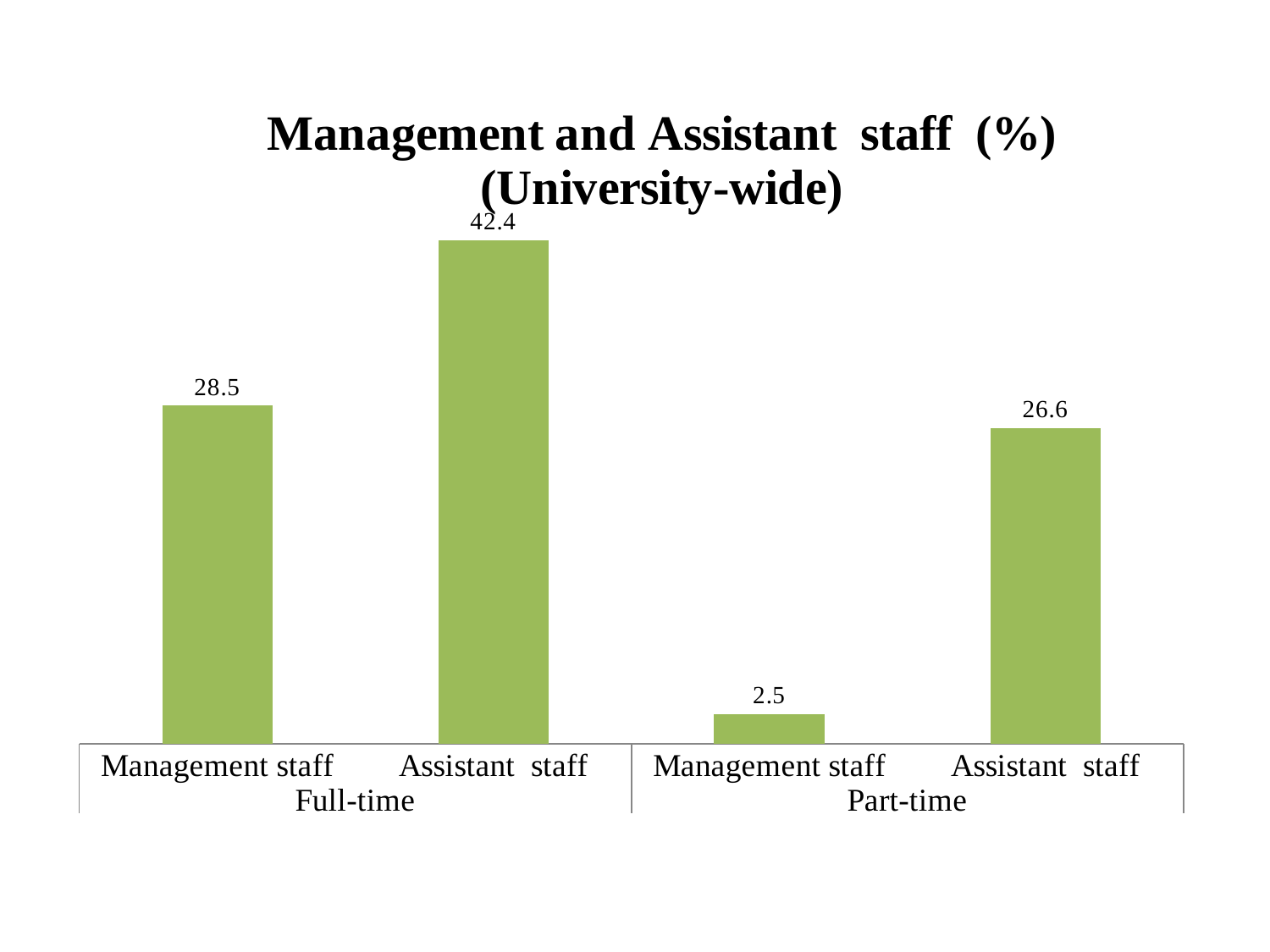
Which category has the highest value? Full-time Assistant staff Which category has the lowest value? Part-time Management staff What is the value for Part-time Assistant staff? 26.6 What kind of chart is shown? Bar chart What is the value for Full-time Management staff? 28.5 What is the value for Full-time Assistant staff? 42.4 Which is larger, Full-time Management staff or Part-time Management staff? Full-time Management staff What is the difference between Full-time Assistant staff and Full-time Management staff? 13.9 How many bars are plotted in the chart? 4 What is the value for Part-time Management staff? 2.5 What is the difference between Full-time Management staff and Part-time Assistant staff? 1.9 What is the title of the chart? Management and Assistant staff (%) (University-wide)